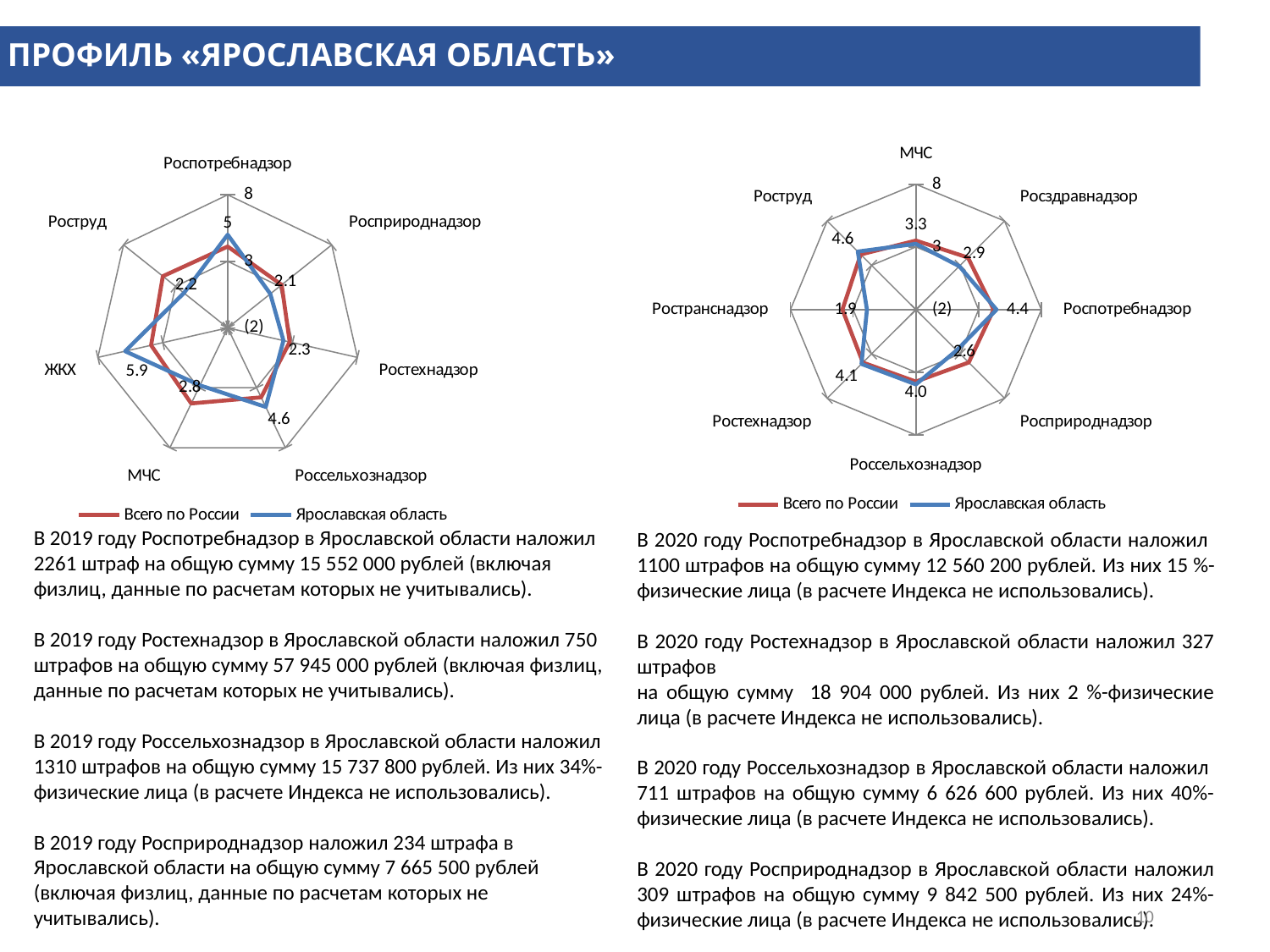
On the left chart, what is the difference between the Ярославская область values for ЖКХ and Росприроднадзор? 3.8 On the right chart, which category has the highest value for Ярославская область? Роструд On the right chart, what is the value for Ярославская область for Роспотребнадзор? 4.4 On the left chart, which is larger for Ярославская область: Роспотребнадзор or Россельхознадзор? Роспотребнадзор How many categories does the right chart have? 8 On the right chart, what is the value for Ярославская область for Ространснадзор? 1.9 On the left chart, what is the value for Ярославская область for ЖКХ? 5.9 How many series does the legend of the right chart list? 2 On the right chart, which category has the lowest value for Ярославская область? Ространснадзор On the left chart, which category has the highest value for Ярославская область? ЖКХ How many categories does the left chart have? 7 On the left chart, what is the value for Ярославская область for Россельхознадзор? 4.6